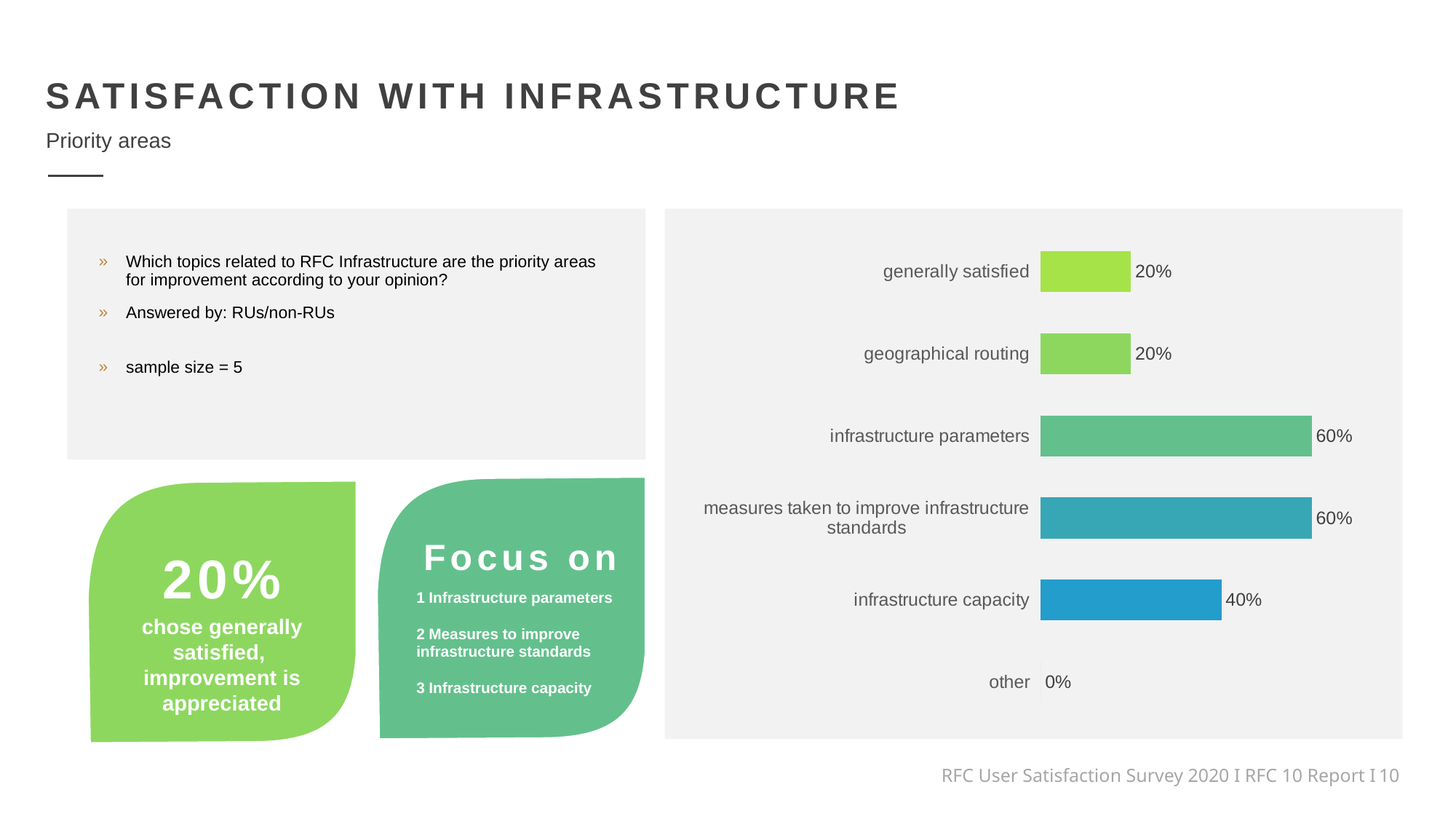
Which category has the lowest value? other What is the sample size stated on the slide? 5 What is the value for geographical routing? 20% What is the value for infrastructure capacity? 40% What is the value for measures taken to improve infrastructure standards? 60% What is the value for other? 0% What is the difference between infrastructure parameters and infrastructure capacity? 20% What is the difference between infrastructure capacity and generally satisfied? 20% Which is larger, the value for infrastructure capacity or the value for geographical routing? infrastructure capacity How many categories are shown in the chart? 6 What kind of chart is shown on the slide? bar chart Which two categories share the highest value of 60%? infrastructure parameters and measures taken to improve infrastructure standards